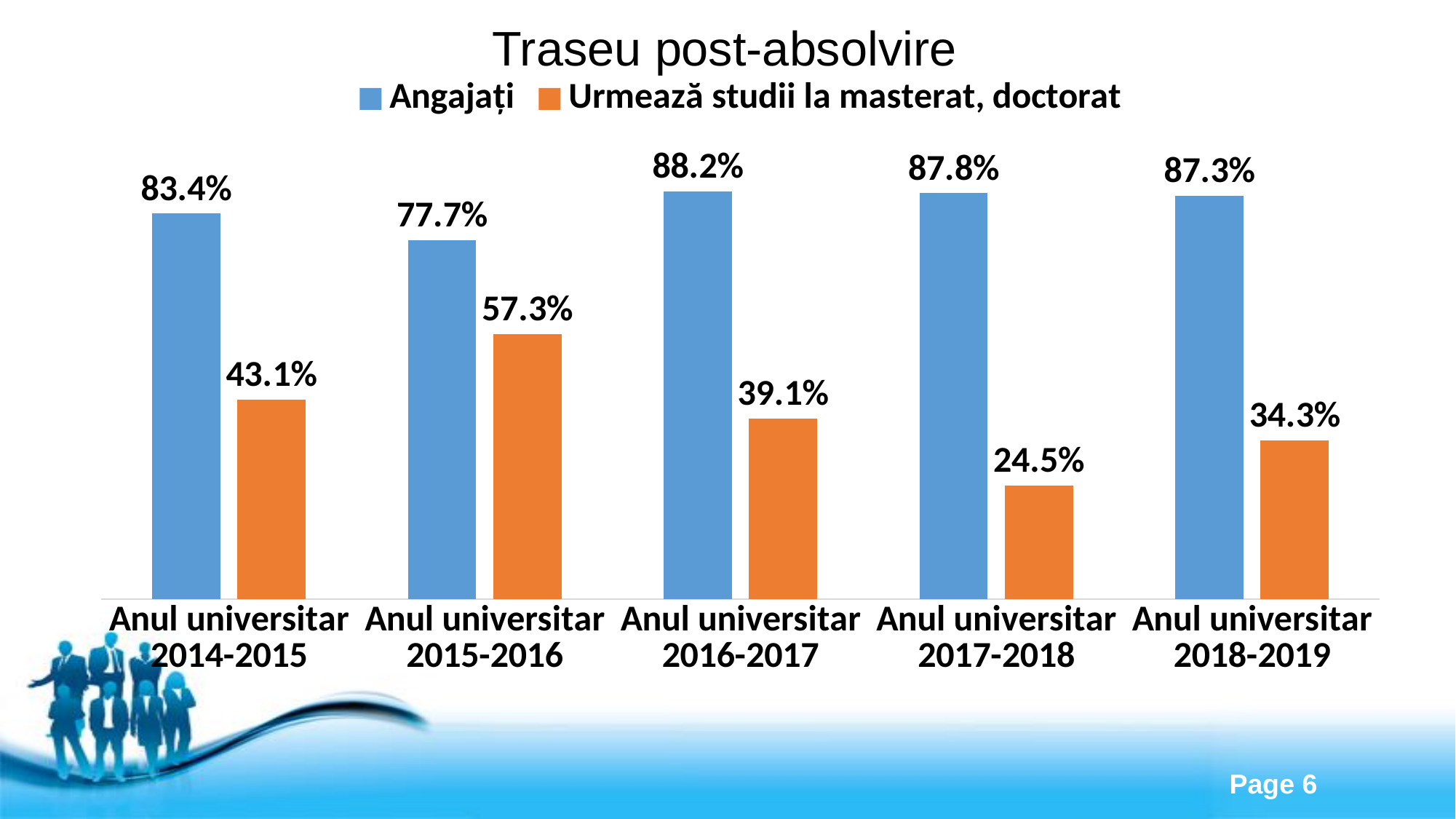
What is the value for Urmează studii la masterat, doctorat in Anul universitar 2017-2018? 24.5% What is the value for Urmează studii la masterat, doctorat in Anul universitar 2015-2016? 57.3% How many series does the legend list? 2 What kind of chart is shown on the slide? Bar chart Which academic year has the lowest value for Urmează studii la masterat, doctorat? Anul universitar 2017-2018 How many academic years are shown on the x axis? 5 Which is larger: Urmează studii la masterat, doctorat in Anul universitar 2014-2015 or in Anul universitar 2016-2017? Anul universitar 2014-2015 What is the value for Angajați in Anul universitar 2014-2015? 83.4% Which academic year has the highest value for Angajați? Anul universitar 2016-2017 Which academic year has the lowest value for Angajați? Anul universitar 2015-2016 What is the title of the chart? Traseu post-absolvire What is the difference between Angajați and Urmează studii la masterat, doctorat in Anul universitar 2018-2019? 53.0%